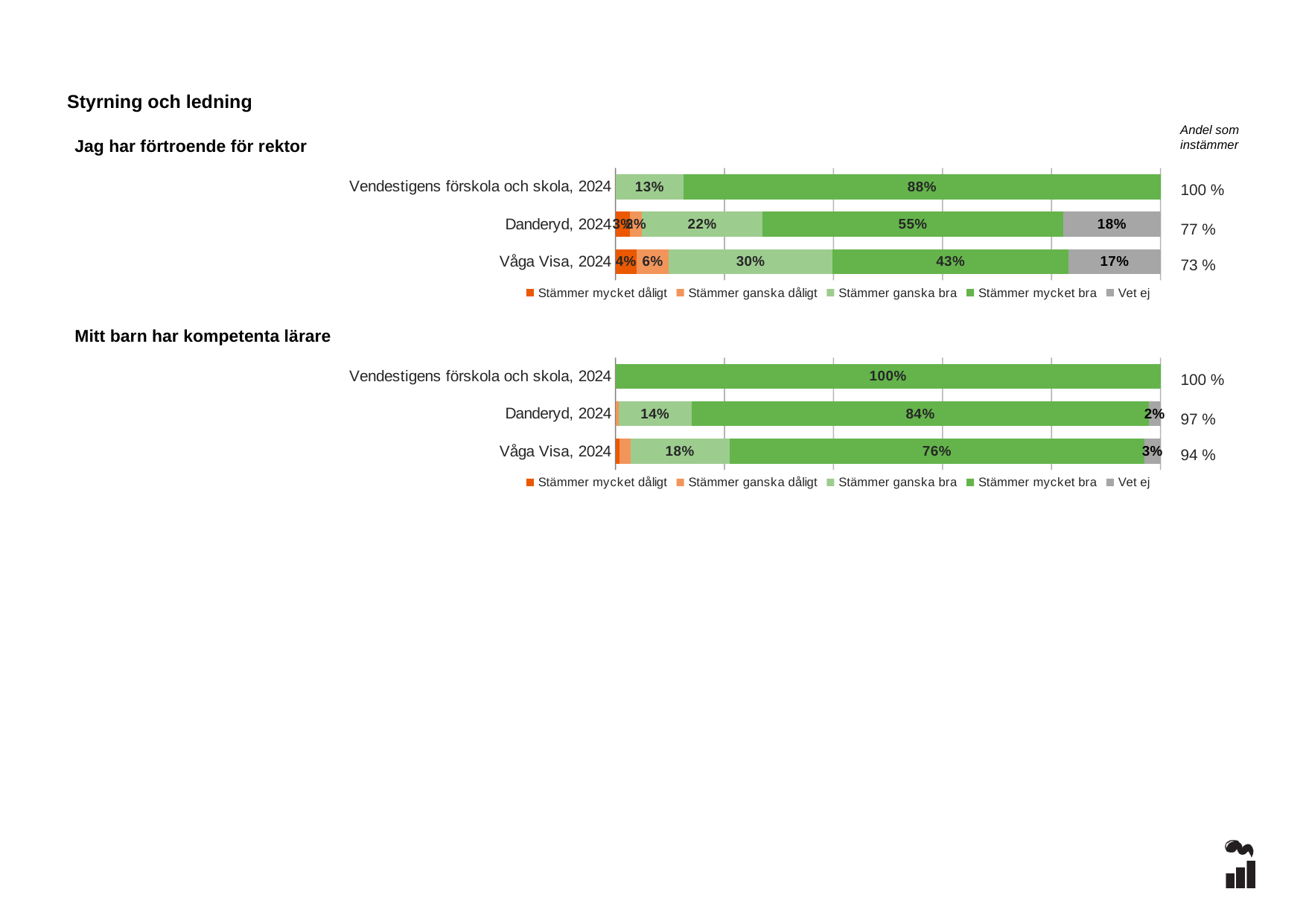
In the chart 'Jag har förtroende för rektor', what is the value for 'Stämmer mycket bra' for Vendestigens förskola och skola, 2024? 88% How many categories are shown in the chart 'Mitt barn har kompetenta lärare'? 3 In the chart 'Mitt barn har kompetenta lärare', what is the value for 'Stämmer mycket bra' for Danderyd, 2024? 84% In the chart 'Jag har förtroende för rektor', which category has the highest 'Stämmer mycket bra' value? Vendestigens förskola och skola, 2024 In the chart 'Mitt barn har kompetenta lärare', which is larger: the 'Stämmer ganska bra' value for Danderyd, 2024 or for Våga Visa, 2024? Våga Visa, 2024 What kind of chart is 'Jag har förtroende för rektor'? Stacked bar chart In the chart 'Jag har förtroende för rektor', what is the value for 'Stämmer ganska bra' for Våga Visa, 2024? 30% In the chart 'Jag har förtroende för rektor', what is the 'Vet ej' value for Danderyd, 2024? 18% In the chart 'Mitt barn har kompetenta lärare', what is the 'Andel som instämmer' shown for Våga Visa, 2024? 94 % How many series does the legend of the chart 'Jag har förtroende för rektor' list? 5 In the chart 'Mitt barn har kompetenta lärare', what is the 'Vet ej' value for Våga Visa, 2024? 3% In the chart 'Jag har förtroende för rektor', what is the difference between the 'Stämmer mycket bra' values for Danderyd, 2024 and Våga Visa, 2024? 12%